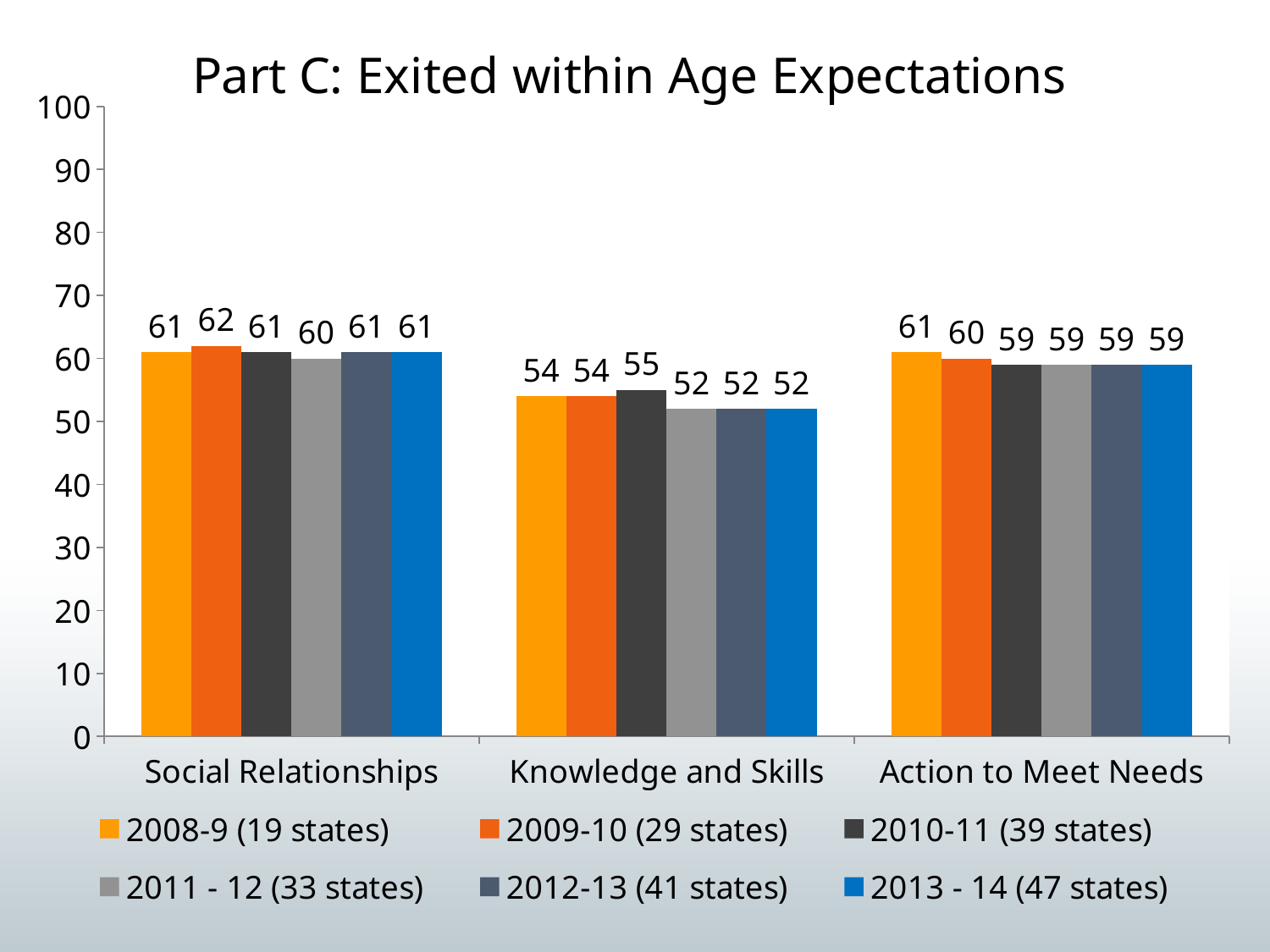
What is the value for Knowledge and Skills in the 2013 - 14 (47 states) series? 52 Which is larger: the 2010-11 (39 states) value for Knowledge and Skills or the 2012-13 (41 states) value for Knowledge and Skills? 2010-11 (39 states) How many series does the legend list? 6 What is the value for Action to Meet Needs in the 2008-9 (19 states) series? 61 What kind of chart is this? Bar chart Which series has the highest value for Social Relationships? 2009-10 (29 states) What is the value for Social Relationships in the 2009-10 (29 states) series? 62 How many categories are shown on the x axis? 3 Which category has the lowest value in the 2012-13 (41 states) series? Knowledge and Skills What is the value for Knowledge and Skills in the 2010-11 (39 states) series? 55 What is the title of the chart? Part C: Exited within Age Expectations What is the difference between the Social Relationships and Knowledge and Skills values in the 2011 - 12 (33 states) series? 8